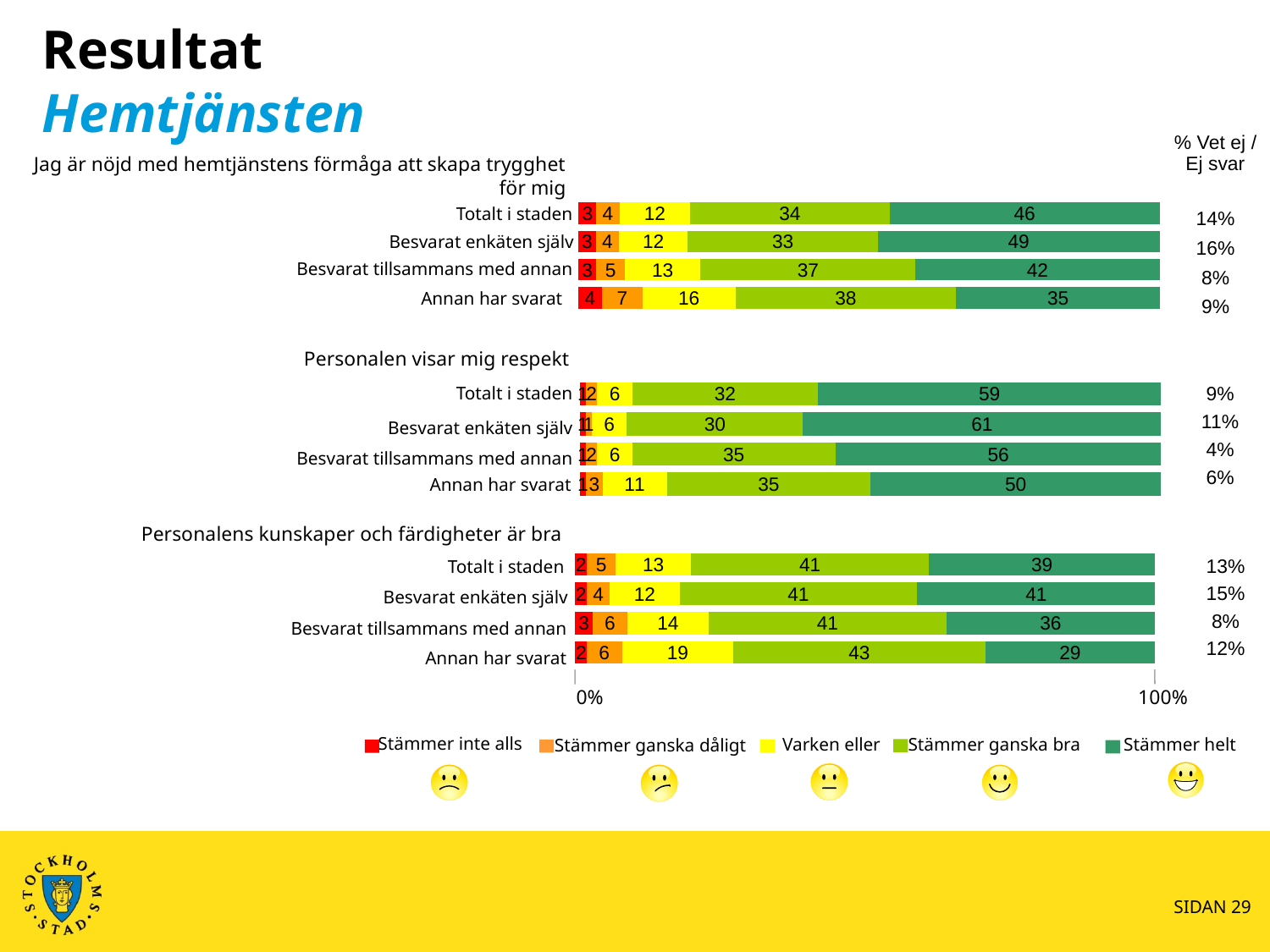
How many series does the legend list? 5 Under "Jag är nöjd med hemtjänstens förmåga att skapa trygghet för mig", what is the "Stämmer ganska bra" value for "Annan har svarat"? 38 Under "Personalens kunskaper och färdigheter är bra", which row has the lowest "Stämmer helt" value? Annan har svarat Under "Personalen visar mig respekt", what is the "Stämmer helt" value for "Besvarat enkäten själv"? 61 Under "Personalen visar mig respekt", is the "Stämmer ganska bra" value larger for "Totalt i staden" or for "Besvarat tillsammans med annan"? Besvarat tillsammans med annan What kind of chart is shown on the slide? Stacked bar chart Which legend entry is shown in red? Stämmer inte alls Under "Personalen visar mig respekt", which row has the highest "Stämmer helt" value? Besvarat enkäten själv How many bars are plotted on the chart in total? 12 What is the "% Vet ej / Ej svar" value for "Besvarat enkäten själv" under "Jag är nöjd med hemtjänstens förmåga att skapa trygghet för mig"? 16% Under "Personalens kunskaper och färdigheter är bra", what is the "Varken eller" value for "Annan har svarat"? 19 Under "Jag är nöjd med hemtjänstens förmåga att skapa trygghet för mig", what is the difference between the "Stämmer helt" values for "Besvarat enkäten själv" and "Annan har svarat"? 14